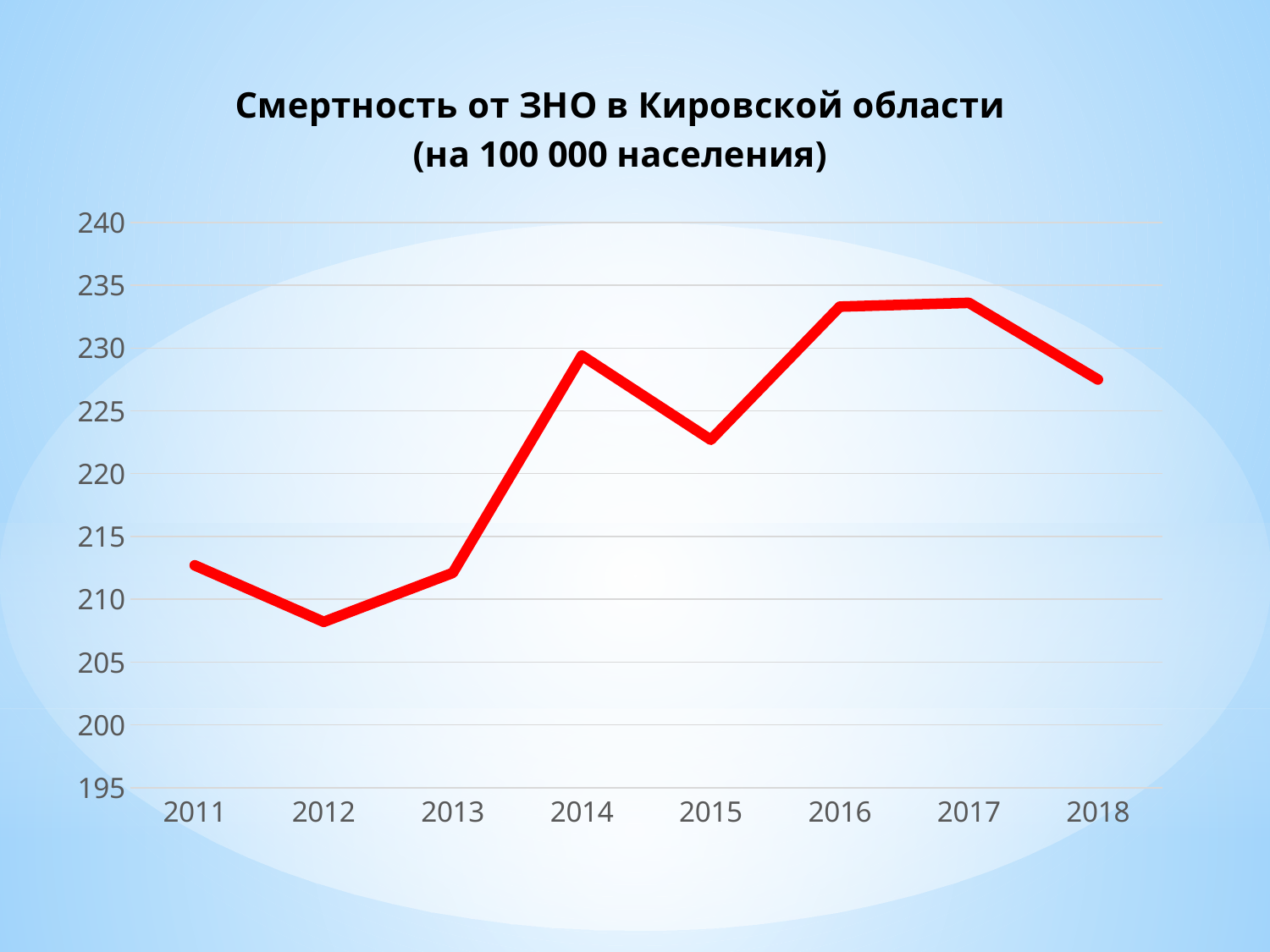
Is the value for 2015 greater or less than 225? less Which is larger, the value for 2014 or the value for 2015? 2014 Is the value for 2016 greater or less than 230? greater Is the value for 2018 greater or less than 230? less What is the title of the chart? Смертность от ЗНО в Кировской области (на 100 000 населения) Which is larger, the value for 2012 or the value for 2018? 2018 Does the value rise or fall from 2017 to 2018? fall What kind of chart is shown on the slide? line chart Which year has the lowest mortality value? 2012 How many years are plotted on the x axis? 8